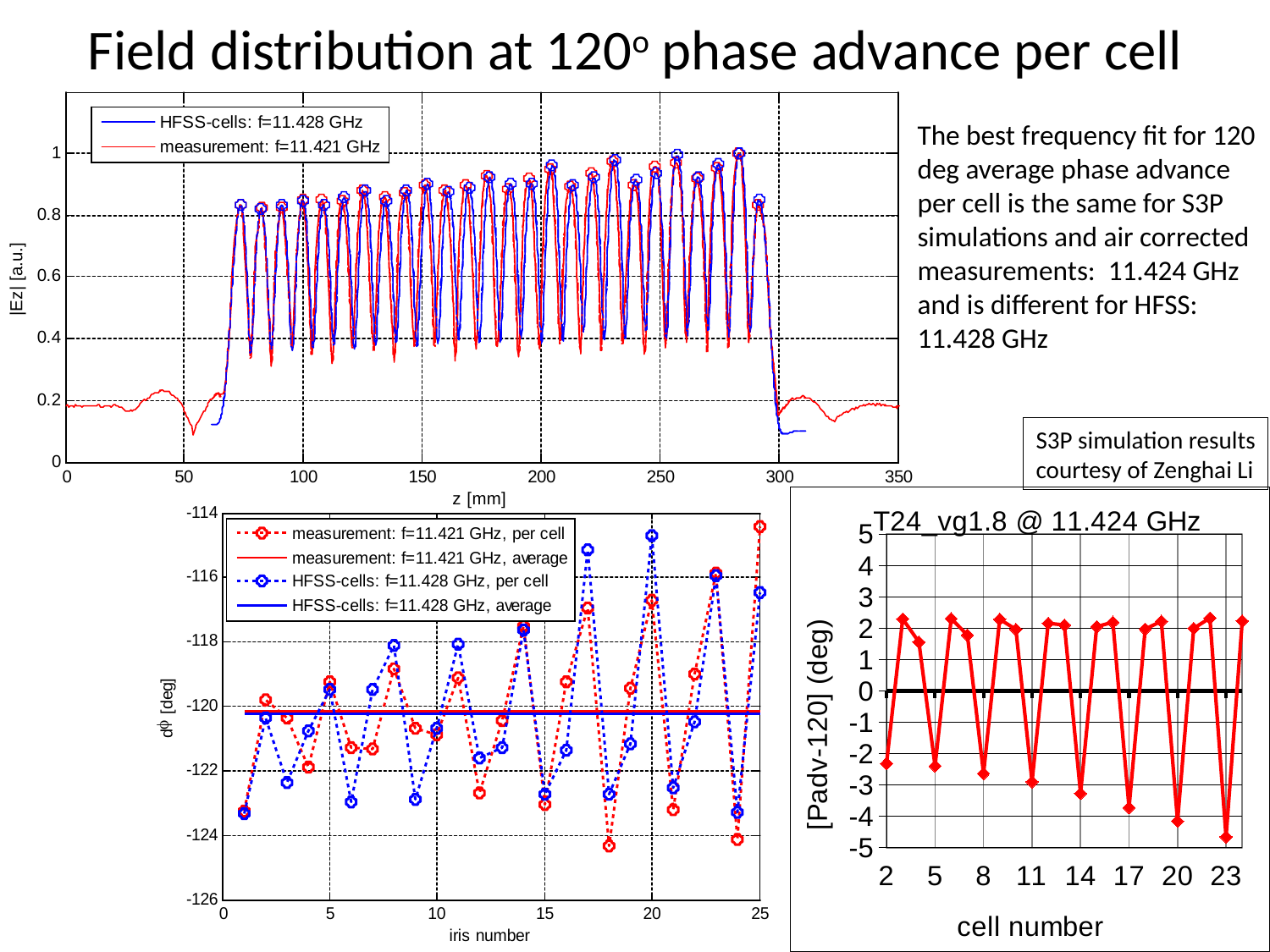
In the bottom-left dφ chart, is the HFSS-cells per-cell value at iris number 20 greater or less than -116? greater What is the title of the bottom-right chart? T24_vg1.8 @ 11.424 GHz What kind of chart is the top-left chart with |Ez| on the y axis? line chart In the bottom-right T24_vg1.8 chart, which cell number has the lowest value? 23 What is the x-axis label of the top-left |Ez| chart? z [mm] What is the x-axis label of the bottom-left dφ chart? iris number How many series does the legend of the top-left |Ez| chart list? 2 In the top-left |Ez| chart, is the measurement value at z = 320 mm greater or less than 0.4? less In the bottom-right T24_vg1.8 chart, is the value at cell number 23 greater or less than -4? less How many entries does the legend of the bottom-left dφ chart list? 4